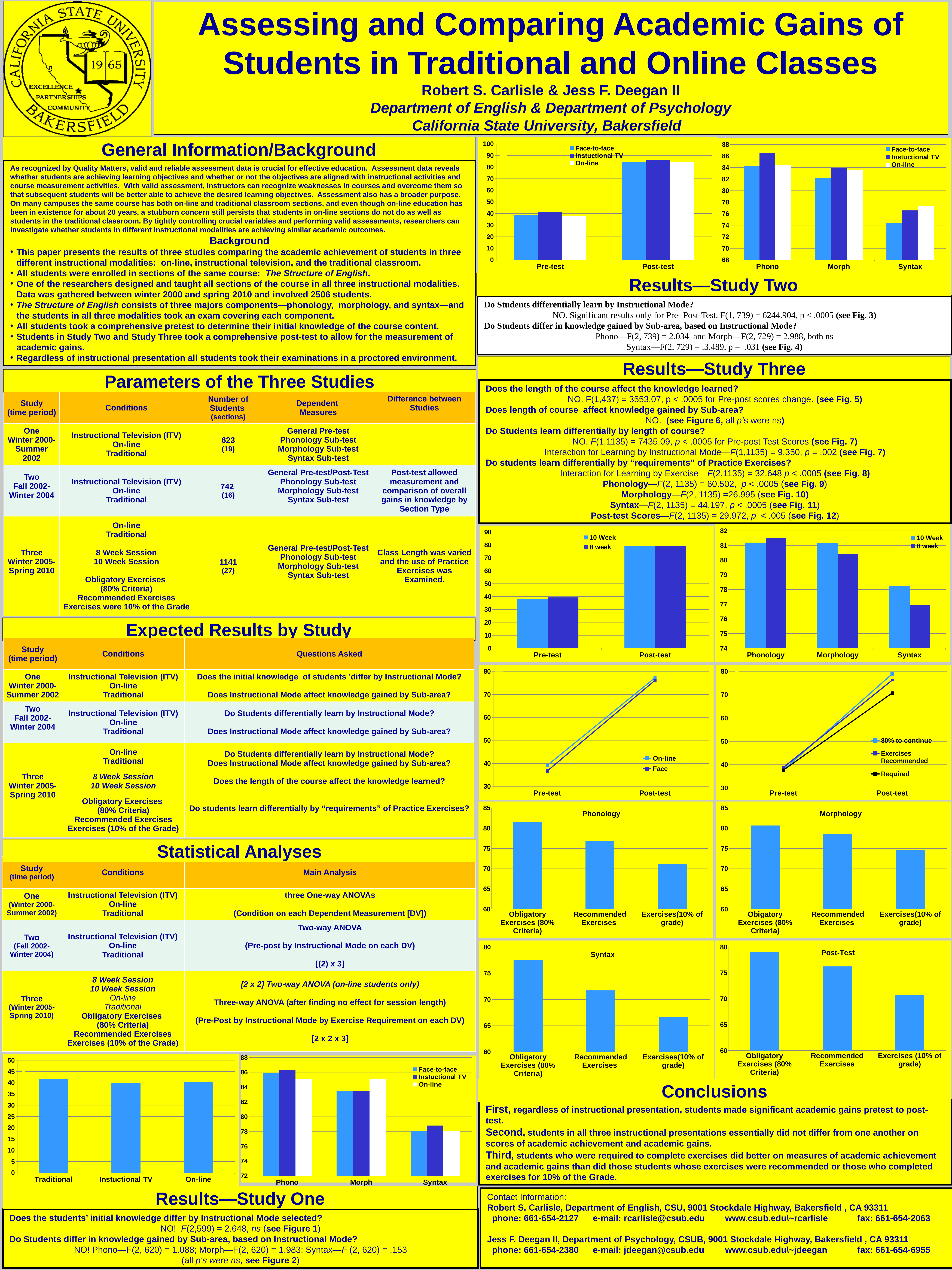
In the Morphology bar chart under Results—Study Three, is the value for Exercises(10% of grade) greater or less than 70? greater In the line chart with the On-line and Face series, do the values rise or fall from Pre-test to Post-test? rise In the Phonology bar chart under Results—Study Three, is the value for Recommended Exercises greater or less than 75? greater In the bar chart at the bottom left with categories Traditional, Instructional TV and On-line, how many categories are shown? 3 In the top-right bar chart showing Phono, Morph and Syntax with a 68–88 axis, is the Face-to-face value for Syntax greater or less than 76? less In the line chart with the legend entries 80% to continue, Exercises Recommended and Required, how many series are listed? 3 In the bar chart showing Phonology, Morphology and Syntax for 10 Week and 8 week sessions, which category has the lowest 8 week value? Syntax In the top-right bar chart showing Pre-test and Post-test with a 0–100 axis, how many series does the legend list? 3 In the Phonology bar chart under Results—Study Three, which category has the highest value? Obligatory Exercises (80% Criteria) In the Syntax bar chart under Results—Study Three, which category has the lowest value? Exercises(10% of grade) What kind of chart is the one showing Pre-test and Post-test for 10 Week and 8 week sessions? bar chart